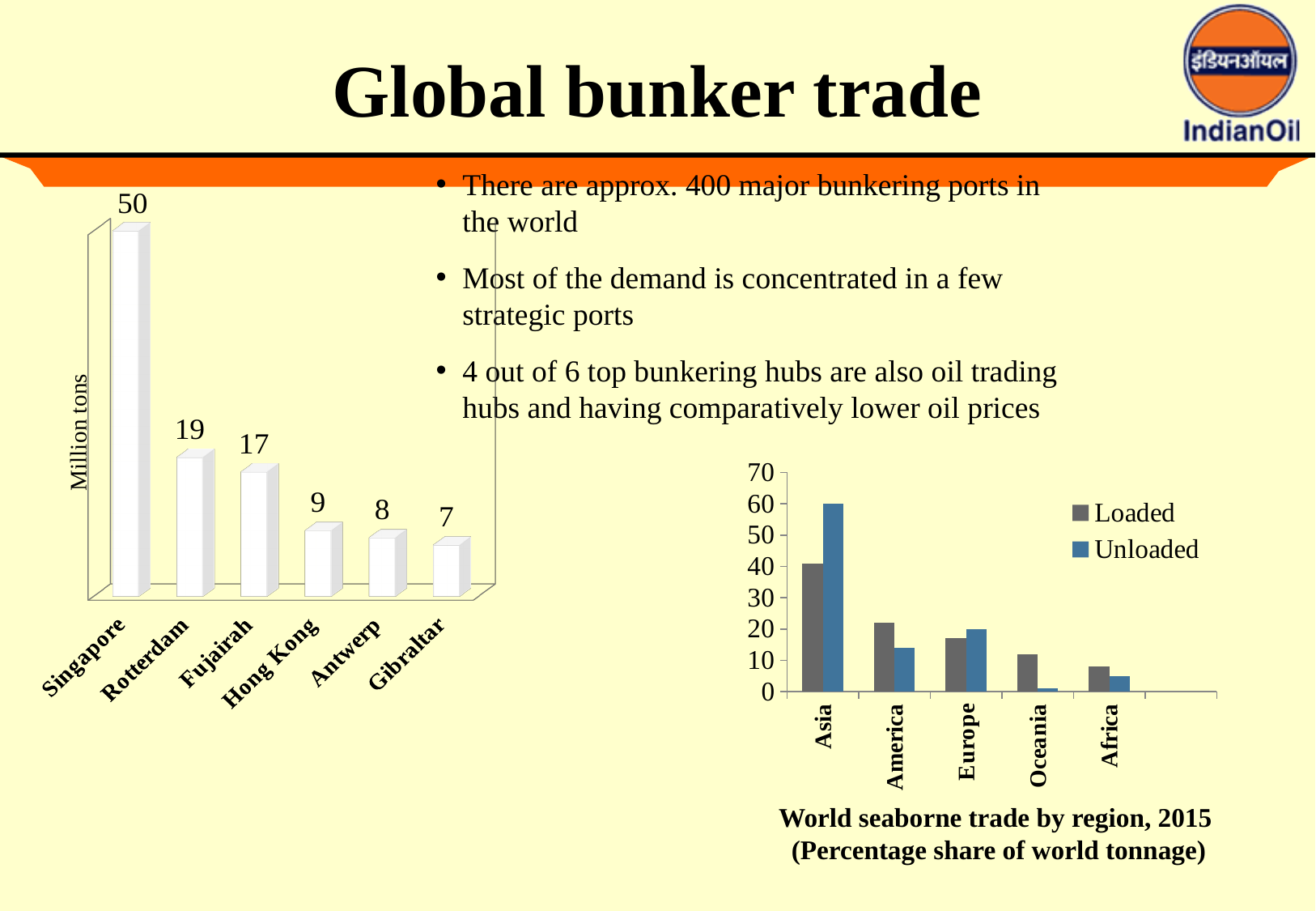
On the left chart, how many ports are shown? 6 On the left chart, what unit is shown on the vertical axis? Million tons On the left chart, do the values rise or fall from Singapore to Gibraltar? fall On the chart titled 'World seaborne trade by region, 2015', how many series does the legend list? 2 On the chart titled 'World seaborne trade by region, 2015', is the Unloaded value for Asia greater or less than 50? greater What kind of chart is the chart titled 'World seaborne trade by region, 2015'? bar chart On the chart titled 'World seaborne trade by region, 2015', which is larger for Asia, Loaded or Unloaded? Unloaded On the left chart, what is the value for Singapore? 50 On the left chart, which port has the lowest value? Gibraltar On the left chart, what is the difference between Singapore and Rotterdam? 31 On the chart titled 'World seaborne trade by region, 2015', is the Unloaded value for Oceania greater or less than 10? less On the left chart, what is the value for Hong Kong? 9